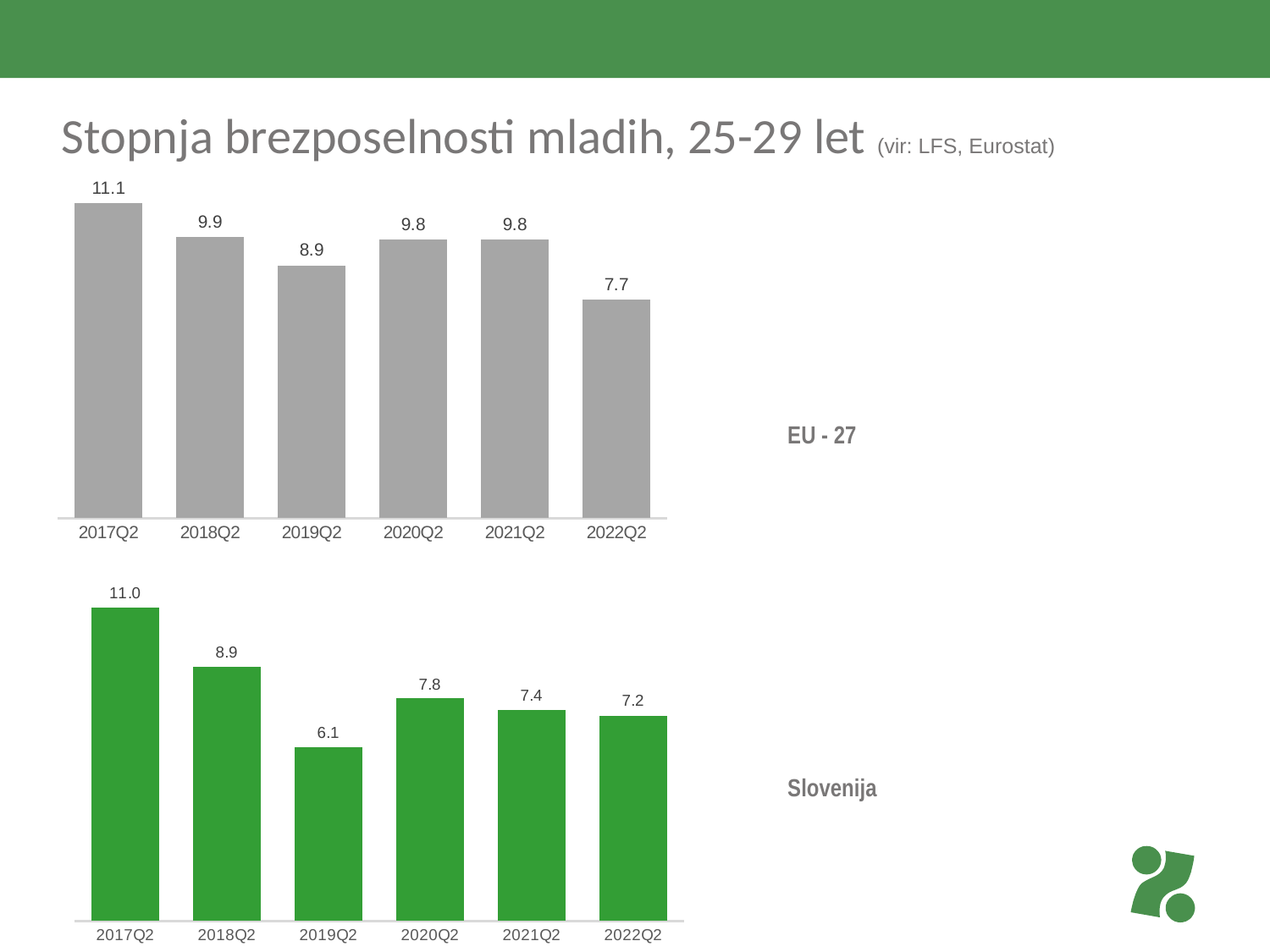
In the Slovenija chart (bottom), what is the difference between the values for 2017Q2 and 2022Q2? 3.8 In the Slovenija chart (bottom), which is larger, the value for 2018Q2 or the value for 2020Q2? 2018Q2 In the Slovenija chart (bottom), which quarter has the highest value? 2017Q2 In the EU - 27 chart (top), what is the value for 2017Q2? 11.1 In the EU - 27 chart (top), which quarter has the lowest value? 2022Q2 What type of chart is the Slovenija chart (bottom)? Bar chart What colour are the bars in the Slovenija chart (bottom)? Green How many quarters are shown in the EU - 27 chart (top)? 6 In the EU - 27 chart (top), what is the value for 2022Q2? 7.7 In the Slovenija chart (bottom), do the values rise or fall from 2017Q2 to 2019Q2? Fall In the Slovenija chart (bottom), what is the value for 2019Q2? 6.1 In the EU - 27 chart (top), what is the difference between the values for 2018Q2 and 2019Q2? 1.0